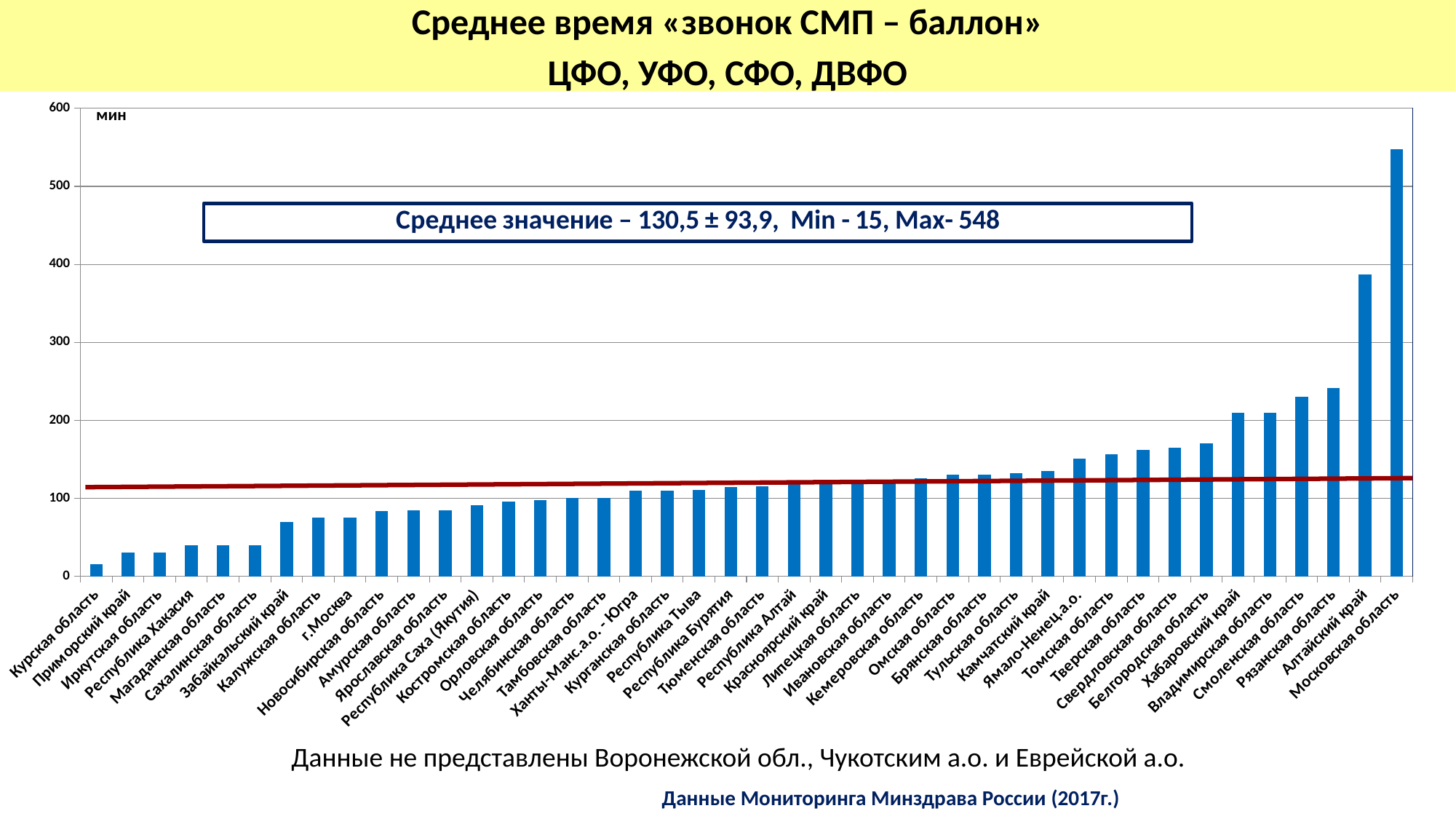
Which region has the lowest value in the chart? Курская область Is the value for Калужская область greater or less than 100? less What is the value for Московская область, according to the Max figure printed on the slide? 548 Do the bar values rise or fall from left to right along the x axis? rise Is the value for Алтайский край greater or less than 300? greater What kind of chart is shown on the slide? bar chart Which is larger, the value for Алтайский край or the value for Рязанская область? Алтайский край Which region has the highest value in the chart? Московская область Is the value for Смоленская область greater or less than 200? greater What is the difference between the maximum (548) and minimum (15) values shown on the slide? 533 What unit is shown at the top of the vertical axis? мин What is the value for Курская область, according to the Min figure printed on the slide? 15